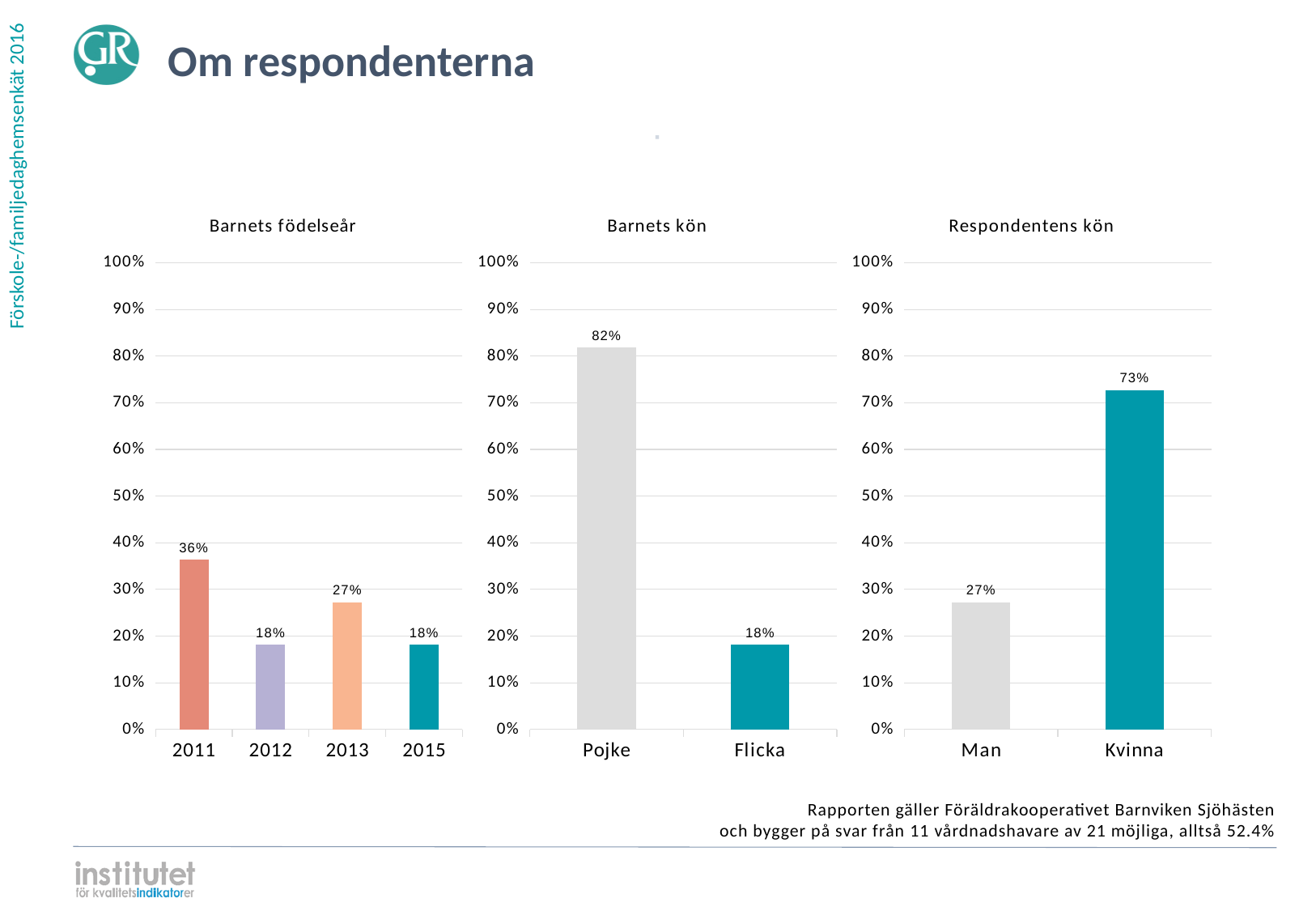
In the 'Respondentens kön' chart, which is larger, Man or Kvinna? Kvinna In the 'Respondentens kön' chart, is the value for Man greater or less than 30%? less In the 'Barnets födelseår' chart, what is the value for 2011? 36% In the 'Barnets födelseår' chart, which birth year has the highest value? 2011 In the 'Barnets födelseår' chart, what is the difference between the values for 2011 and 2013? 9% In the 'Barnets kön' chart, what is the difference between Pojke and Flicka? 64% In the 'Barnets kön' chart, what is the value for Pojke? 82% What kind of chart is the 'Barnets kön' chart? Bar chart In the 'Barnets kön' chart, which category is lowest? Flicka In the 'Respondentens kön' chart, what is the value for Kvinna? 73% In the 'Barnets födelseår' chart, how many birth-year categories are shown? 4 What is the title of the chart on the right of the slide? Respondentens kön